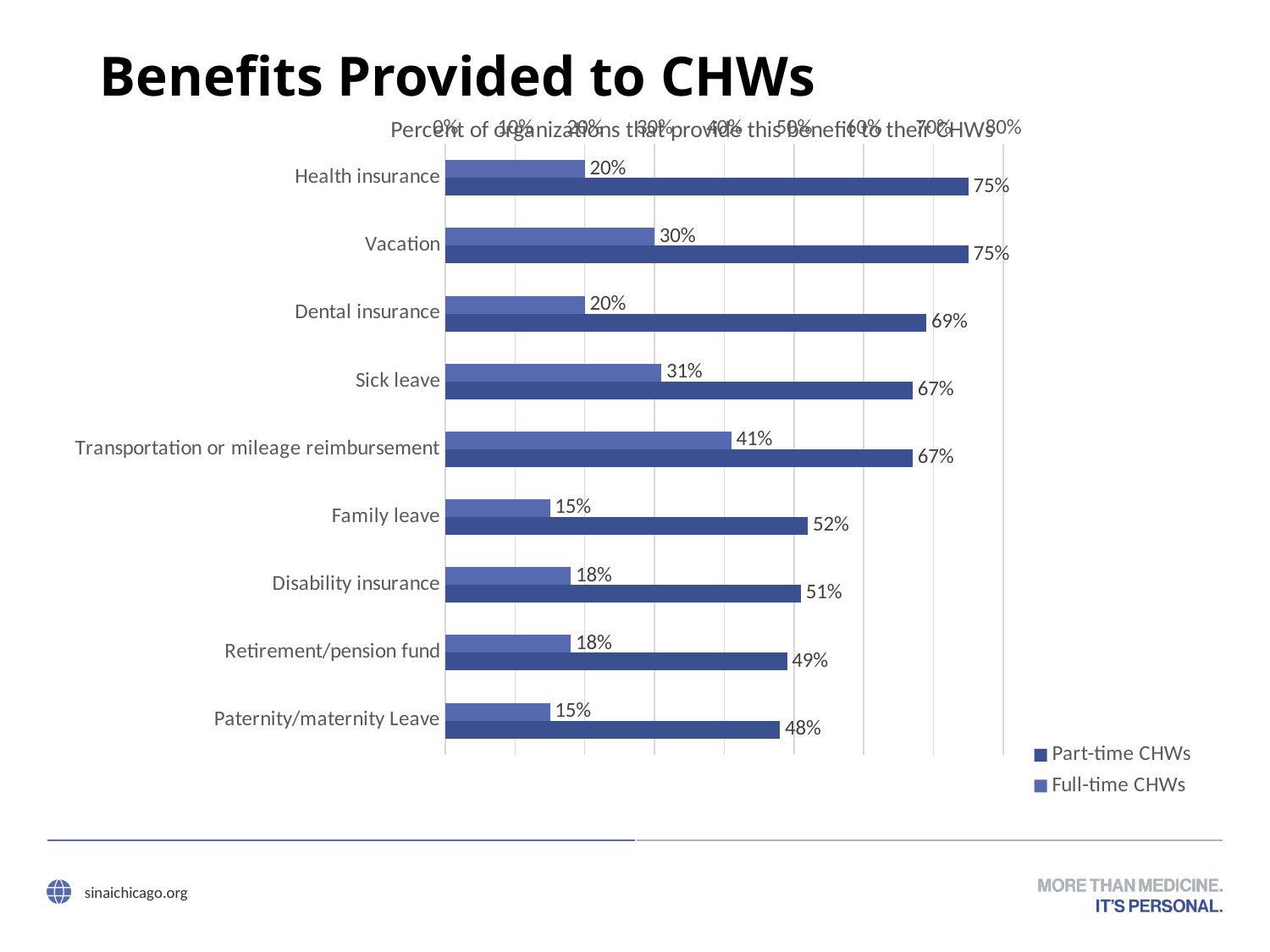
What is the smaller of the two values shown for Vacation? 30% How many benefit categories are listed on the chart? 9 What type of chart is shown on the slide? bar chart How many series does the legend list? 2 Among the shorter (lighter blue) bars, which benefit has the highest value? Transportation or mileage reimbursement What is the larger of the two values shown for Dental insurance? 69% What are the two series named in the legend? Part-time CHWs and Full-time CHWs Which is larger: the smaller value for Sick leave or the smaller value for Family leave? Sick leave Among the longer (dark blue) bars, which benefit has the lowest value? Paternity/maternity Leave What is the difference between the two values shown for Health insurance? 55 percentage points What is the larger of the two values shown for Health insurance? 75% What is the smaller of the two values shown for Transportation or mileage reimbursement? 41%